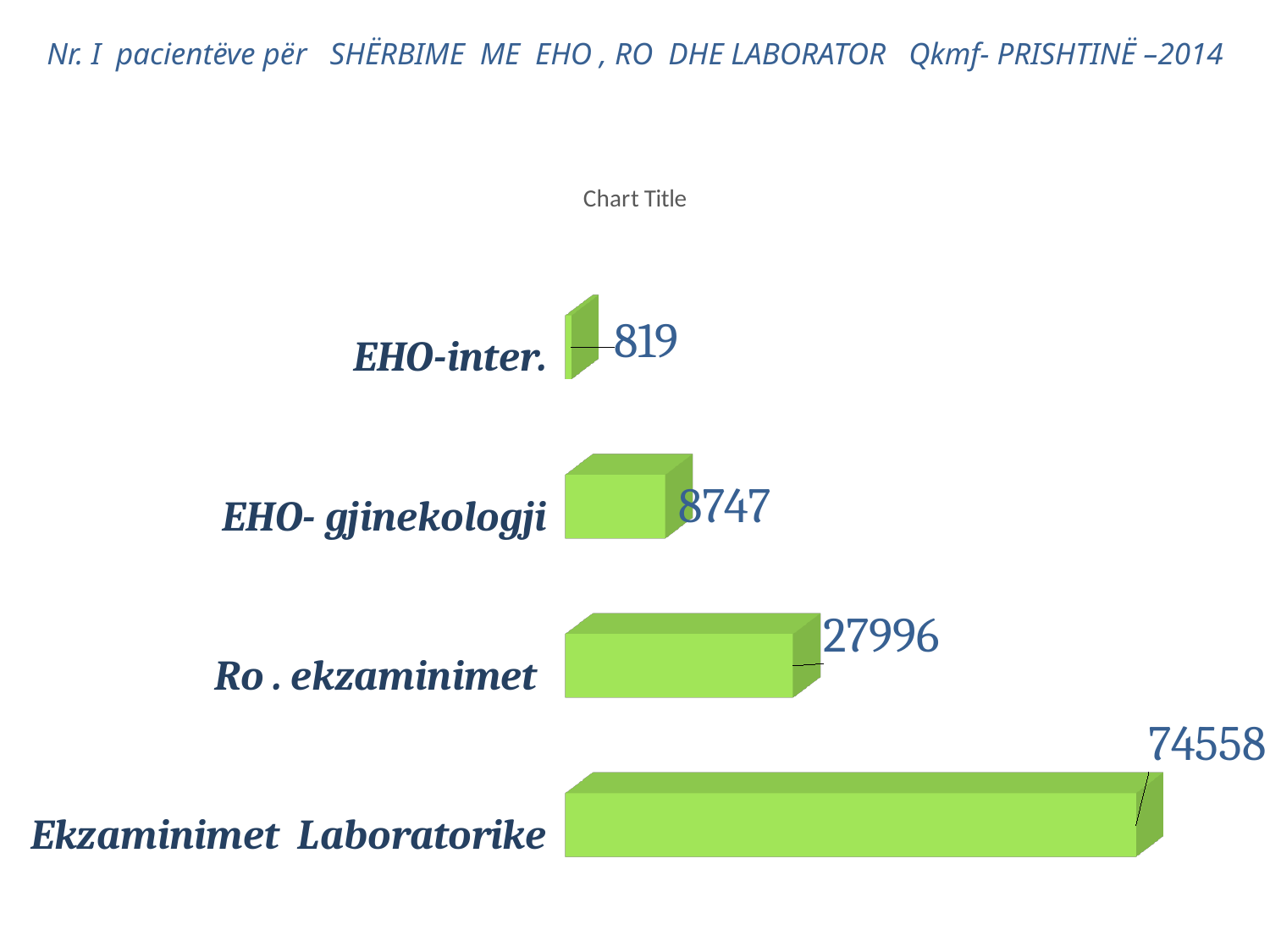
What is the difference between the values for Ekzaminimet Laboratorike and Ro . ekzaminimet? 46562 What is the value for EHO- gjinekologji? 8747 What is the value for Ro . ekzaminimet? 27996 What is the title shown above the chart? Chart Title Which category has the lowest value? EHO-inter. What is the value for EHO-inter.? 819 What kind of chart is shown on the slide? Bar chart What is the value for Ekzaminimet Laboratorike? 74558 How many categories are shown in the chart? 4 What is the difference between the values for EHO- gjinekologji and EHO-inter.? 7928 Which category has the highest value? Ekzaminimet Laboratorike Which is larger, the value for Ro . ekzaminimet or the value for EHO- gjinekologji? Ro . ekzaminimet